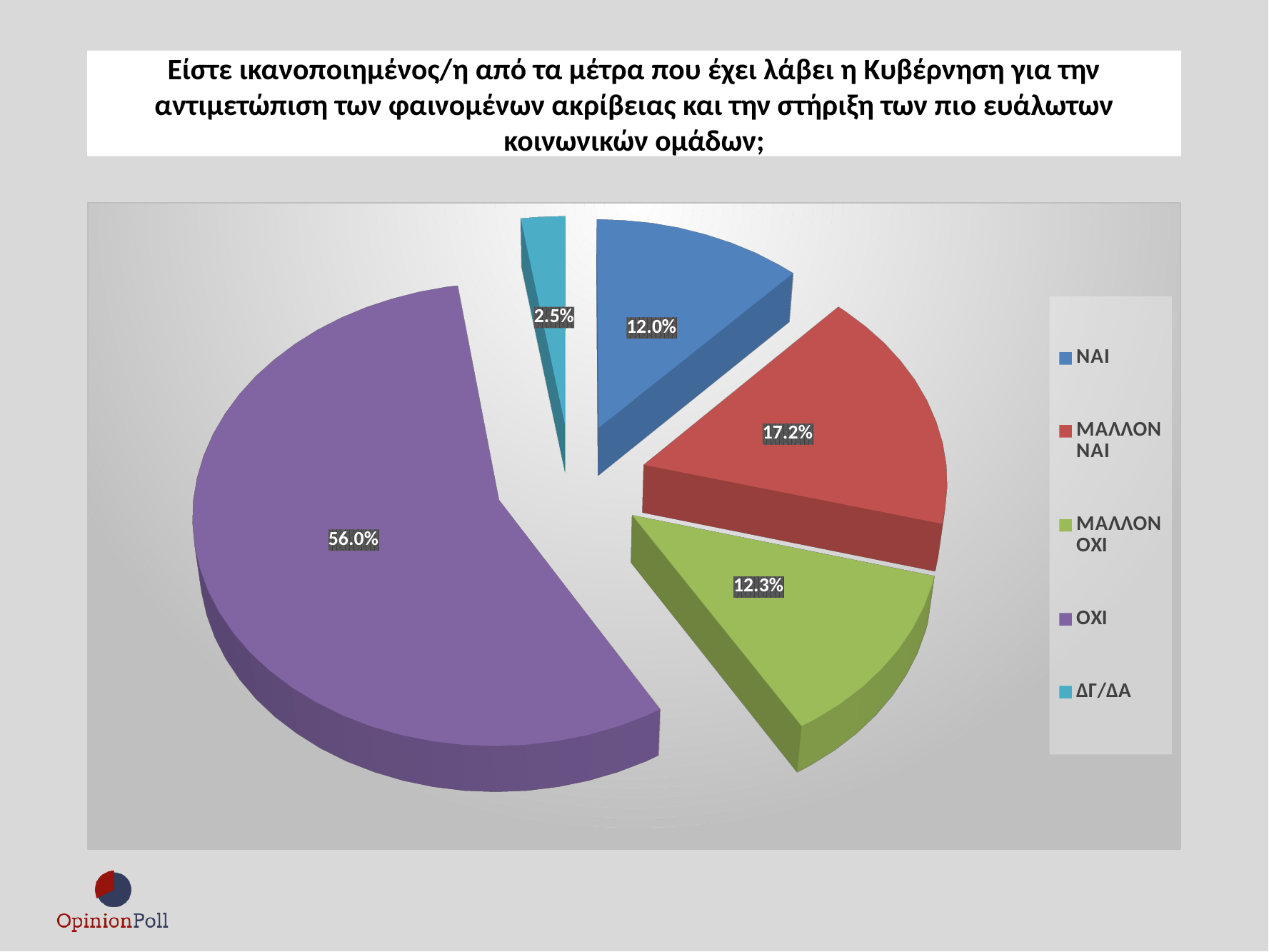
What percentage is shown for ΜΑΛΛΟΝ ΝΑΙ? 17.2% What is the difference in percentage points between ΟΧΙ and ΜΑΛΛΟΝ ΝΑΙ? 38.8 What colour is the slice for ΟΧΙ? Purple Which category has the smallest share of the pie? ΔΓ/ΔΑ Which category has the largest share of the pie? ΟΧΙ What type of chart is shown on the slide? Pie chart What percentage is shown for ΟΧΙ? 56.0% How many slices does the pie chart have? 5 What percentage is shown for ΔΓ/ΔΑ? 2.5% What percentage is shown for ΝΑΙ? 12.0% Which is larger, the share for ΜΑΛΛΟΝ ΝΑΙ or the share for ΜΑΛΛΟΝ ΟΧΙ? ΜΑΛΛΟΝ ΝΑΙ What percentage is shown for ΜΑΛΛΟΝ ΟΧΙ? 12.3%